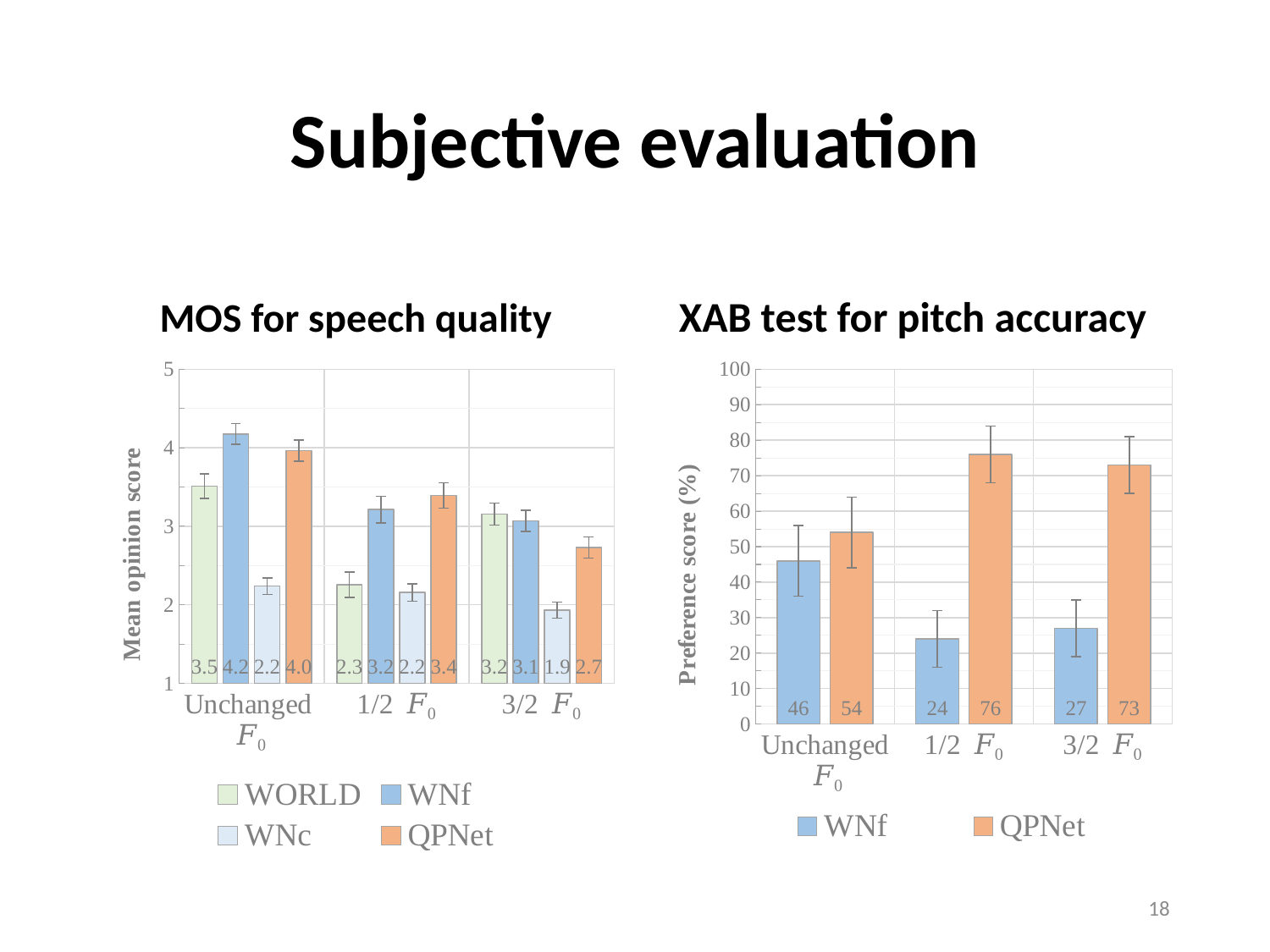
What kind of chart is the XAB test for pitch accuracy chart? Bar chart In the MOS for speech quality chart, what is the mean opinion score for QPNet at 1/2 F0? 3.4 In the MOS for speech quality chart, which system has the lowest score at 3/2 F0? WNc In the XAB test for pitch accuracy chart, what is the label of the y axis? Preference score (%) In the MOS for speech quality chart, what is the difference between the WNf and WNc scores at Unchanged F0? 2.0 In the XAB test for pitch accuracy chart, what is the preference score for QPNet at 1/2 F0? 76 In the MOS for speech quality chart, what is the mean opinion score for WNf at Unchanged F0? 4.2 In the XAB test for pitch accuracy chart, what is the difference between the QPNet and WNf scores at Unchanged F0? 8 In the MOS for speech quality chart, which is larger at 3/2 F0: WORLD or QPNet? WORLD In the MOS for speech quality chart, how many series does the legend list? 4 In the XAB test for pitch accuracy chart, how many categories are shown on the x axis? 3 In the XAB test for pitch accuracy chart, what is the preference score for WNf at 3/2 F0? 27